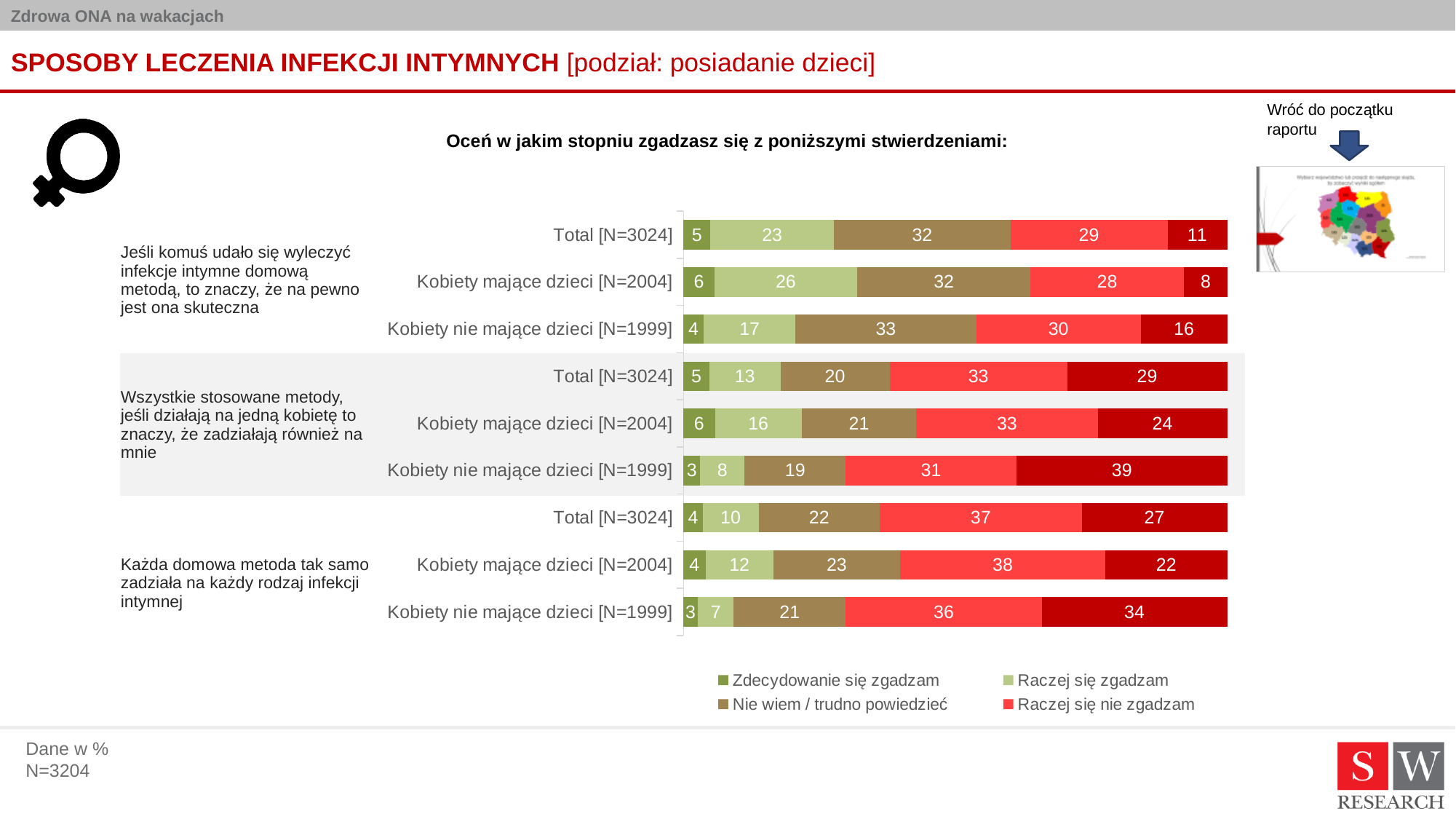
What kind of chart is shown on the slide? Stacked bar chart For the statement 'Wszystkie stosowane metody, jeśli działają na jedną kobietę to znaczy, że zadziałają również na mnie', what is the 'Zdecydowanie się zgadzam' value for Total [N=3024]? 5 For the statement 'Wszystkie stosowane metody, jeśli działają na jedną kobietę to znaczy, że zadziałają również na mnie', what is the 'Raczej się nie zgadzam' value for Kobiety nie mające dzieci [N=1999]? 31 What is the total of all segments in the Total [N=3024] bar for the first statement? 100 For the statement 'Każda domowa metoda tak samo zadziała na każdy rodzaj infekcji intymnej', which group has the larger 'Raczej się nie zgadzam' value: Kobiety mające dzieci [N=2004] or Kobiety nie mające dzieci [N=1999]? Kobiety mające dzieci [N=2004] Among the three Total [N=3024] rows, which statement has the highest 'Nie wiem / trudno powiedzieć' value? Jeśli komuś udało się wyleczyć infekcje intymne domową metodą, to znaczy, że na pewno jest ona skuteczna For the statement 'Wszystkie stosowane metody, jeśli działają na jedną kobietę to znaczy, że zadziałają również na mnie', which group has the lowest 'Raczej się zgadzam' value? Kobiety nie mające dzieci [N=1999] How many bars are plotted in the chart? 9 For the first statement (about a home method that cured someone being surely effective), what is the difference in 'Raczej się zgadzam' between Kobiety mające dzieci [N=2004] and Kobiety nie mające dzieci [N=1999]? 9 For the statement 'Jeśli komuś udało się wyleczyć infekcje intymne domową metodą, to znaczy, że na pewno jest ona skuteczna', what is the 'Raczej się zgadzam' value for Total [N=3024]? 23 What question is shown as the chart's heading? Oceń w jakim stopniu zgadzasz się z poniższymi stwierdzeniami: For the statement 'Każda domowa metoda tak samo zadziała na każdy rodzaj infekcji intymnej', what is the 'Nie wiem / trudno powiedzieć' value for Kobiety mające dzieci [N=2004]? 23